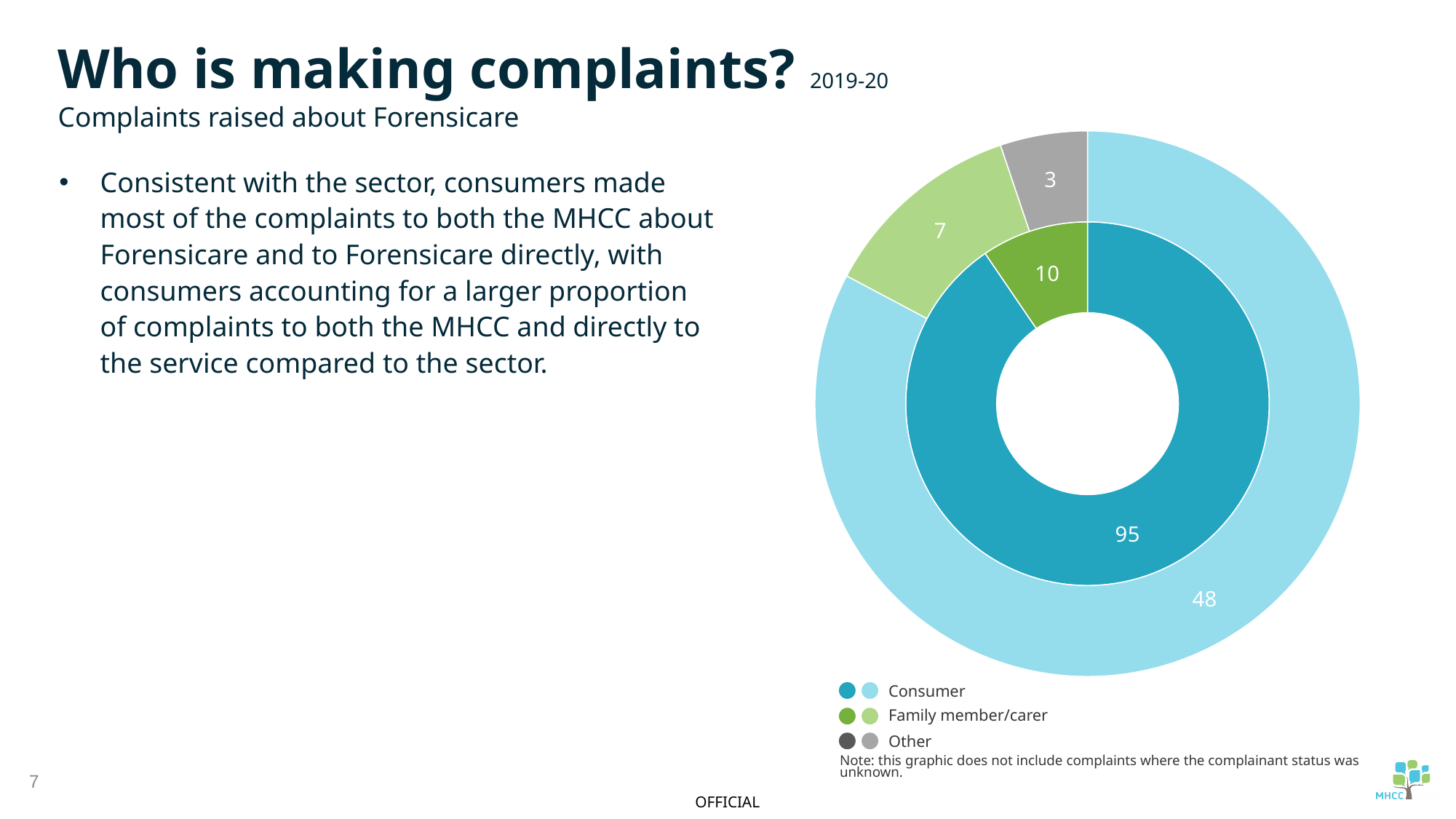
In the inner ring of the doughnut chart, what is the value for Consumer? 95 In the inner ring of the doughnut chart, what is the value for Family member/carer? 10 In the inner ring, how much larger is the Consumer value than the Family member/carer value? 85 In the outer ring of the doughnut chart, what is the value for Family member/carer? 7 Which category has the smallest segment in the outer ring of the doughnut chart? Other Which is larger: the Consumer value in the inner ring or the Consumer value in the outer ring? Inner ring (95) In the outer ring of the doughnut chart, what is the value for Consumer? 48 Which category has the largest segment in the outer ring of the doughnut chart? Consumer How many categories does the legend of the doughnut chart list? 3 What is the total of the values shown in the outer ring of the doughnut chart? 58 What kind of chart is shown on the slide? Doughnut chart In the outer ring of the doughnut chart, what is the value for Other? 3